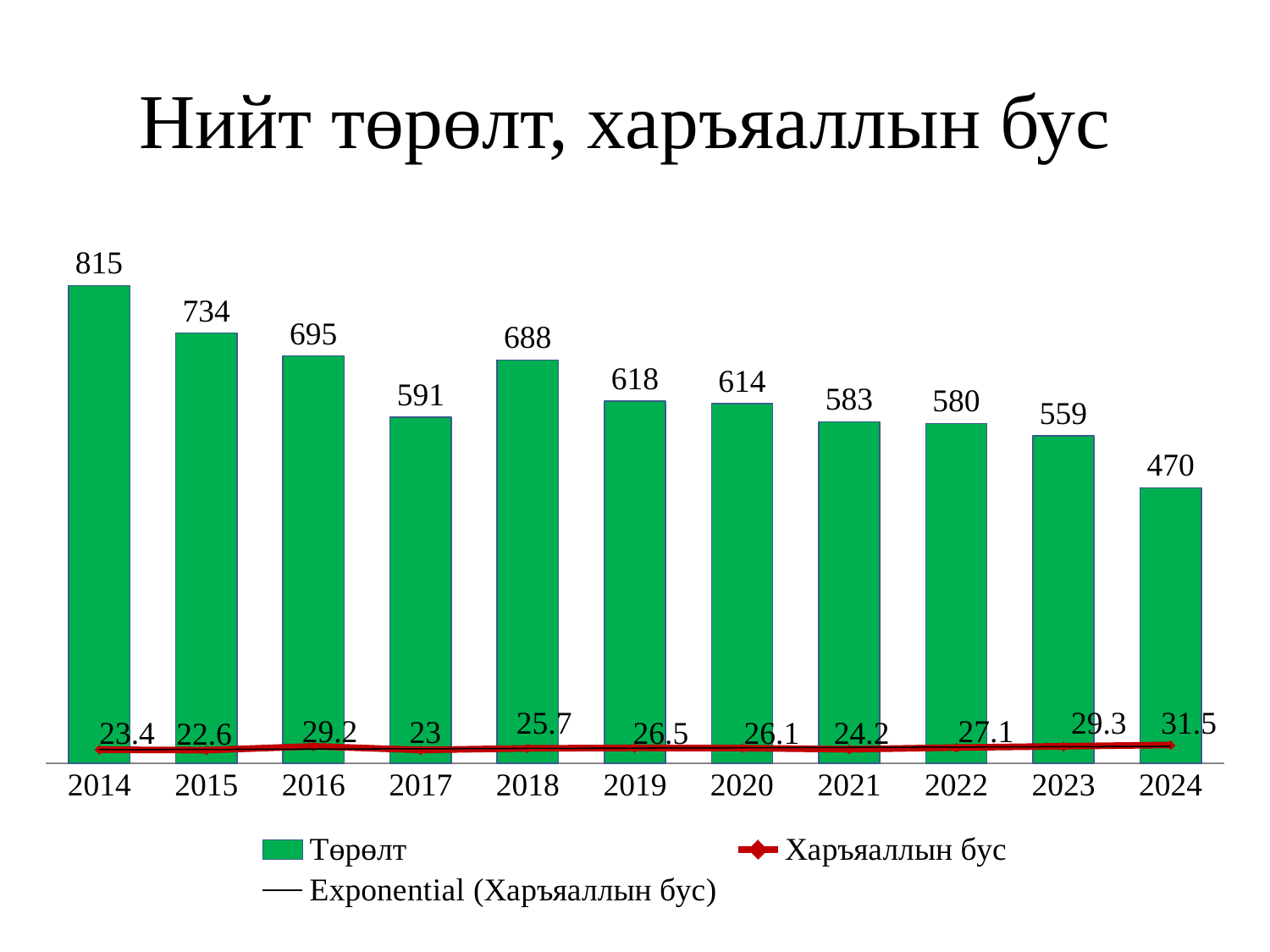
Which is larger, the Төрөлт value for 2017 or for 2018? 2018 What is the Харъяаллын бус value for 2016? 29.2 What is the Төрөлт value for 2014? 815 What is the Төрөлт value for 2024? 470 What is the difference between the Төрөлт values for 2014 and 2024? 345 What is the Харъяаллын бус value for 2024? 31.5 Which year has the lowest Төрөлт value? 2024 How many years are shown on the x axis? 11 How many entries does the legend list? 3 Which year has the lowest Харъяаллын бус value? 2015 What is the title of the chart? Нийт төрөлт, харъяаллын бус Which year has the highest Төрөлт value? 2014